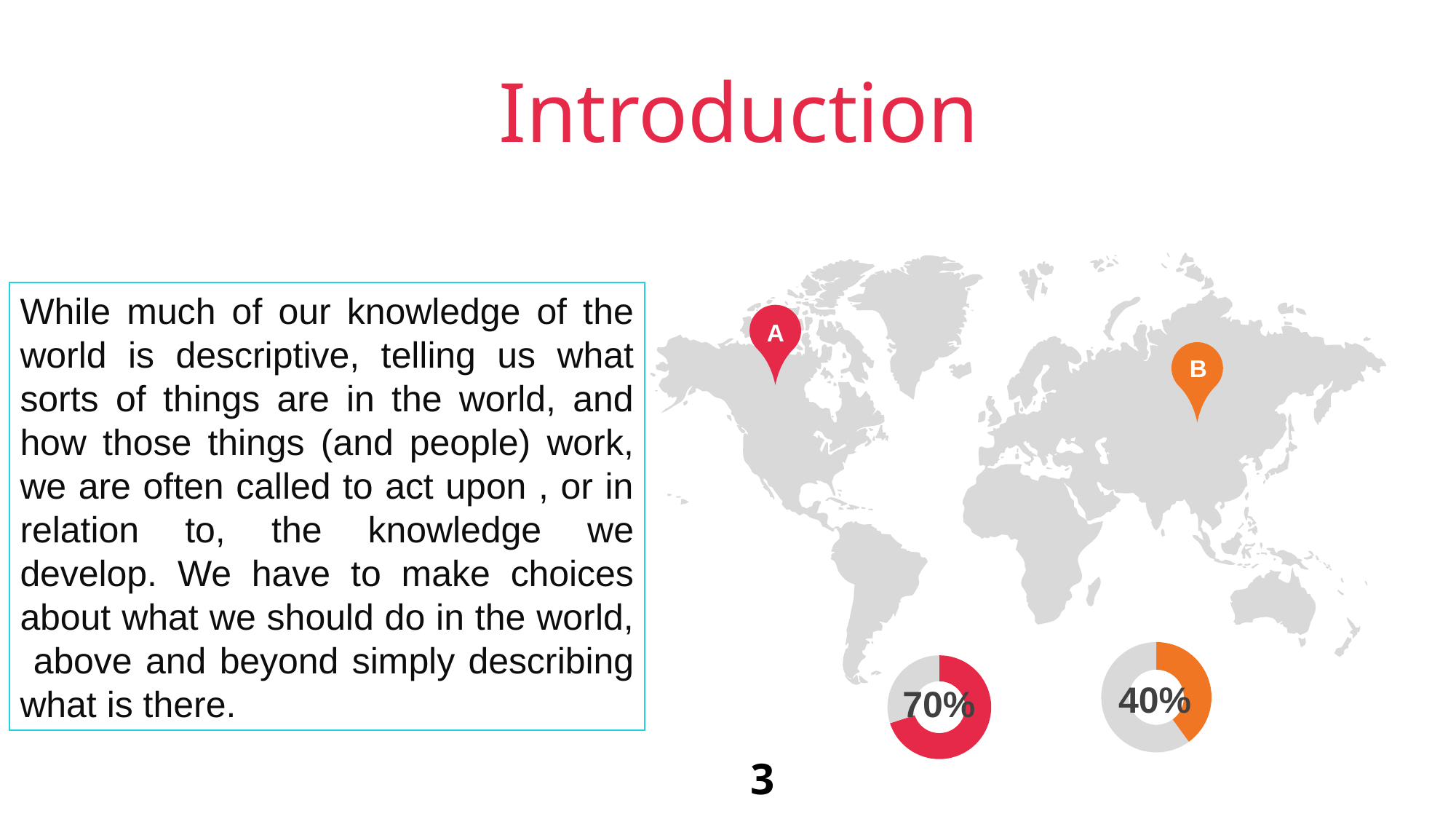
What is the difference between the percentages shown on the red and orange donut charts? 30 percentage points Which donut chart shows the lowest percentage? the orange one (40%) What value is shown on the orange donut chart at the bottom of the slide? 40% What kind of charts are shown at the bottom right of the slide? donut (pie) charts Which donut chart shows the higher percentage, the red one or the orange one? the red one Which map marker shares its colour with the donut chart showing 70%? A How many donut charts are on the slide? 2 What value is shown on the red donut chart at the bottom of the slide? 70% Is the value on the orange donut chart greater or less than 50%? less Which map marker shares its colour with the donut chart showing 40%? B Is the value on the red donut chart greater or less than 50%? greater